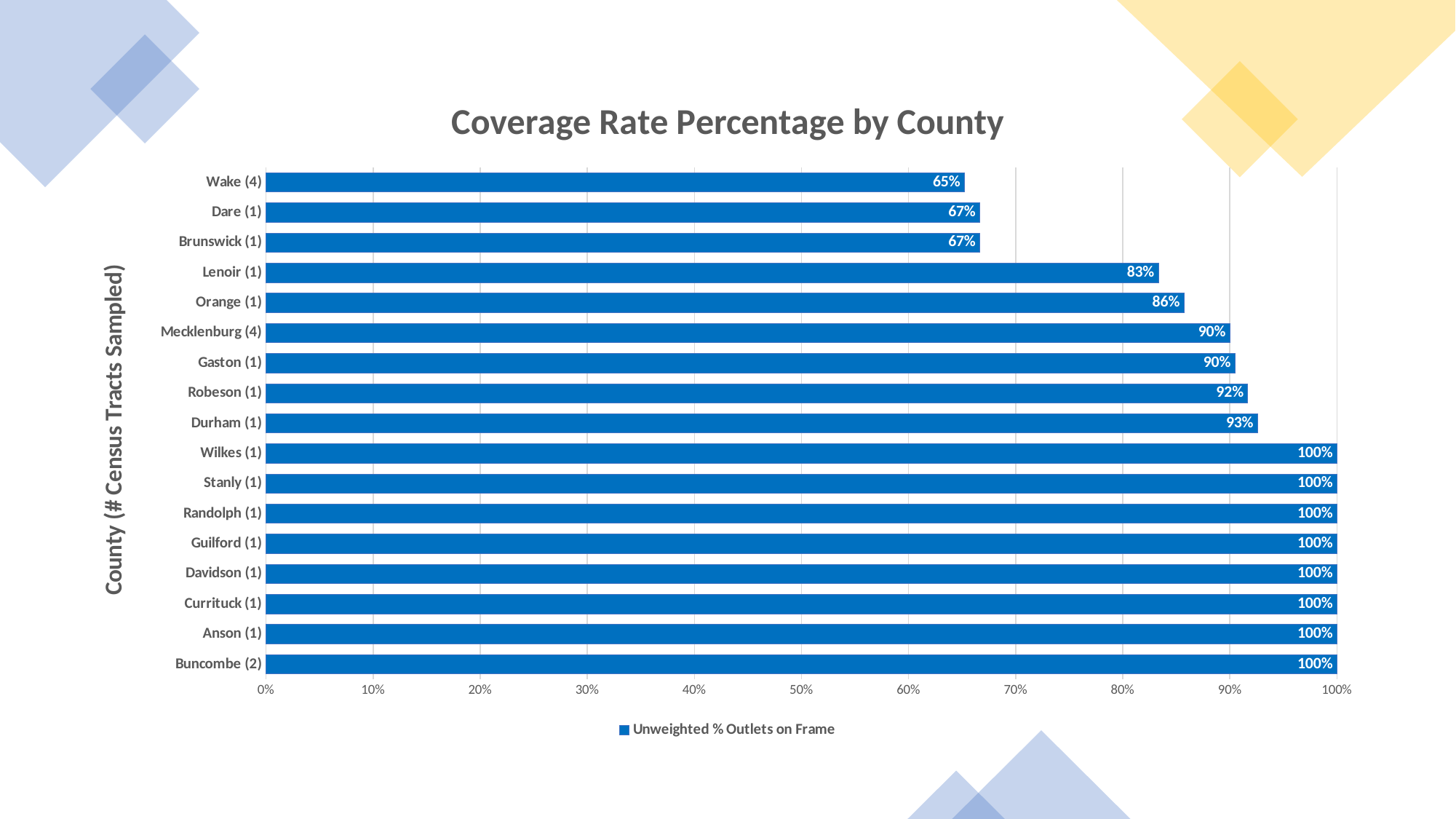
How many series does the legend list? 1 Which county has the lowest coverage rate percentage? Wake (4) What is the coverage rate percentage for Orange (1)? 86% What is the coverage rate percentage for Durham (1)? 93% How many counties are shown on the chart? 17 What is the difference between the coverage rate for Lenoir (1) and Wake (4)? 18% Is the value for Mecklenburg (4) greater or less than 80%? greater How many counties have a coverage rate of 100%? 8 What kind of chart is shown on the slide? Bar chart What is the title of the chart? Coverage Rate Percentage by County Which has a higher coverage rate, Robeson (1) or Orange (1)? Robeson (1) What is the coverage rate percentage for Wake (4)? 65%